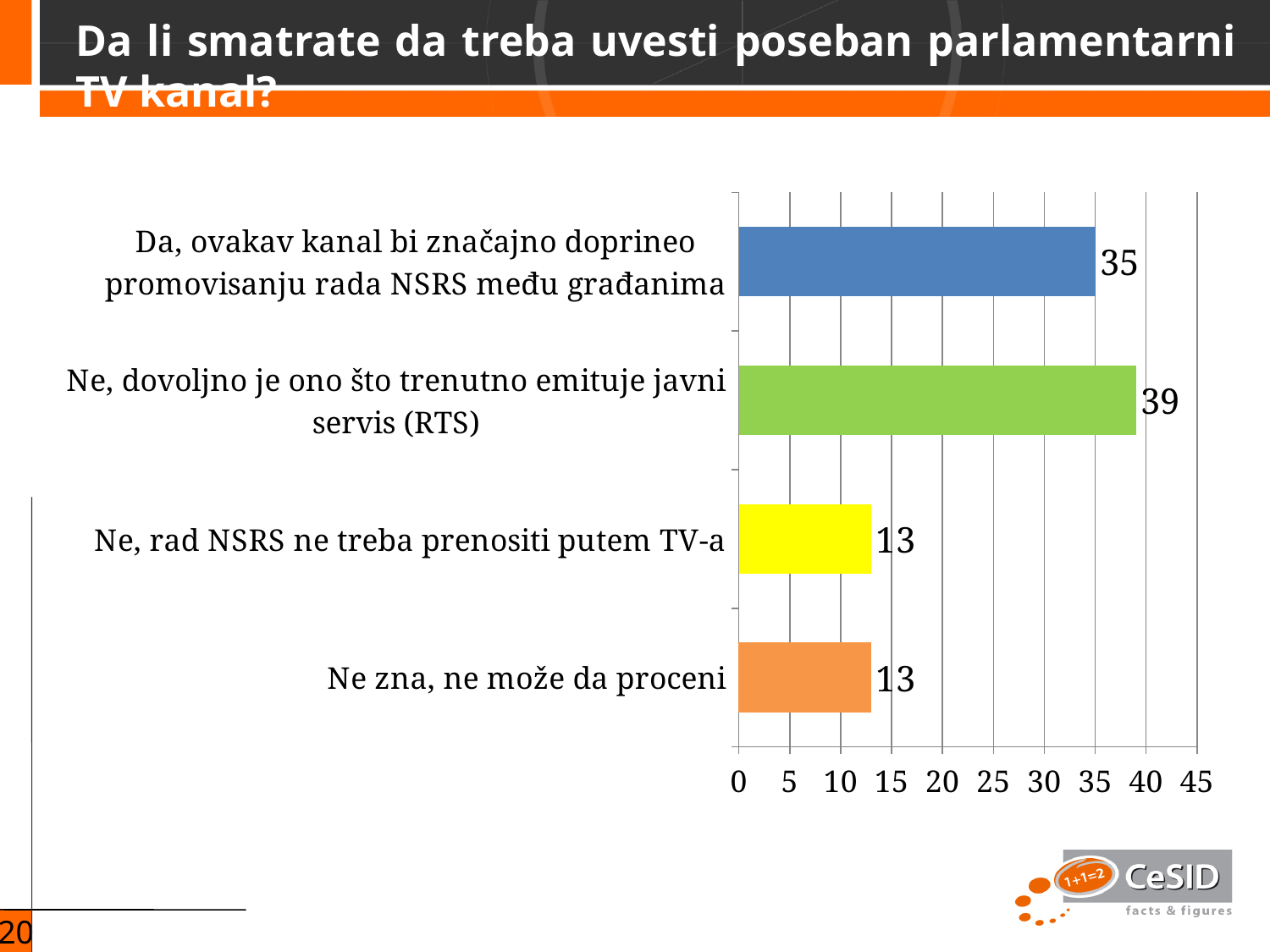
Is the value for "Ne, rad NSRS ne treba prenositi putem TV-a" greater or less than 20? less What is the maximum value shown on the horizontal axis? 45 What is the value for "Ne, dovoljno je ono što trenutno emituje javni servis (RTS)"? 39 What is the difference between the values for "Da, ovakav kanal bi značajno doprineo promovisanju rada NSRS među građanima" and "Ne zna, ne može da proceni"? 22 What is the value for "Ne zna, ne može da proceni"? 13 Which is larger: the value for "Da, ovakav kanal bi značajno doprineo promovisanju rada NSRS među građanima" or the value for "Ne, rad NSRS ne treba prenositi putem TV-a"? Da, ovakav kanal bi značajno doprineo promovisanju rada NSRS među građanima How many categories are shown in the chart? 4 What colour is the bar for "Ne, dovoljno je ono što trenutno emituje javni servis (RTS)"? green What is the value for "Da, ovakav kanal bi značajno doprineo promovisanju rada NSRS među građanima"? 35 What kind of chart is shown on the slide? bar chart What is the difference between the values for "Ne, dovoljno je ono što trenutno emituje javni servis (RTS)" and "Da, ovakav kanal bi značajno doprineo promovisanju rada NSRS među građanima"? 4 Which category has the highest value? Ne, dovoljno je ono što trenutno emituje javni servis (RTS)